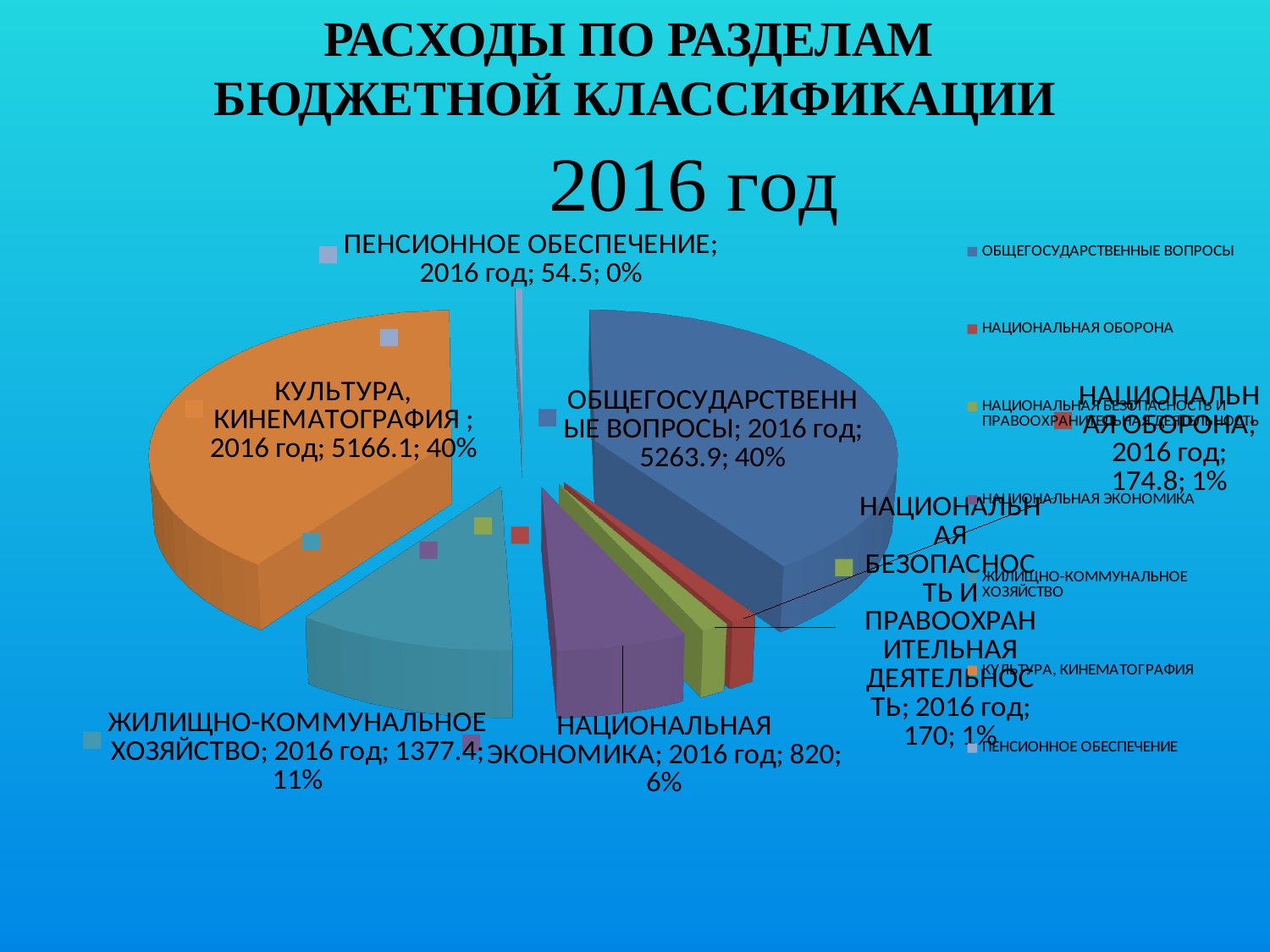
What is the value for КУЛЬТУРА, КИНЕМАТОГРАФИЯ in 2016? 5166.1 What is the value for ОБЩЕГОСУДАРСТВЕННЫЕ ВОПРОСЫ in 2016? 5263.9 What is the value for ПЕНСИОННОЕ ОБЕСПЕЧЕНИЕ in 2016? 54.5 What is the difference between the values for НАЦИОНАЛЬНАЯ ОБОРОНА and НАЦИОНАЛЬНАЯ БЕЗОПАСНОСТЬ И ПРАВООХРАНИТЕЛЬНАЯ ДЕЯТЕЛЬНОСТЬ? 4.8 What is the value for ЖИЛИЩНО-КОММУНАЛЬНОЕ ХОЗЯЙСТВО in 2016? 1377.4 Which category has the largest value? ОБЩЕГОСУДАРСТВЕННЫЕ ВОПРОСЫ What share of the pie does ЖИЛИЩНО-КОММУНАЛЬНОЕ ХОЗЯЙСТВО represent? 11% Which category has the smallest value? ПЕНСИОННОЕ ОБЕСПЕЧЕНИЕ How many categories does the legend list? 7 What is the value for НАЦИОНАЛЬНАЯ ЭКОНОМИКА in 2016? 820 What share of the pie does НАЦИОНАЛЬНАЯ ОБОРОНА represent? 1% What kind of chart is shown on the slide? Pie chart